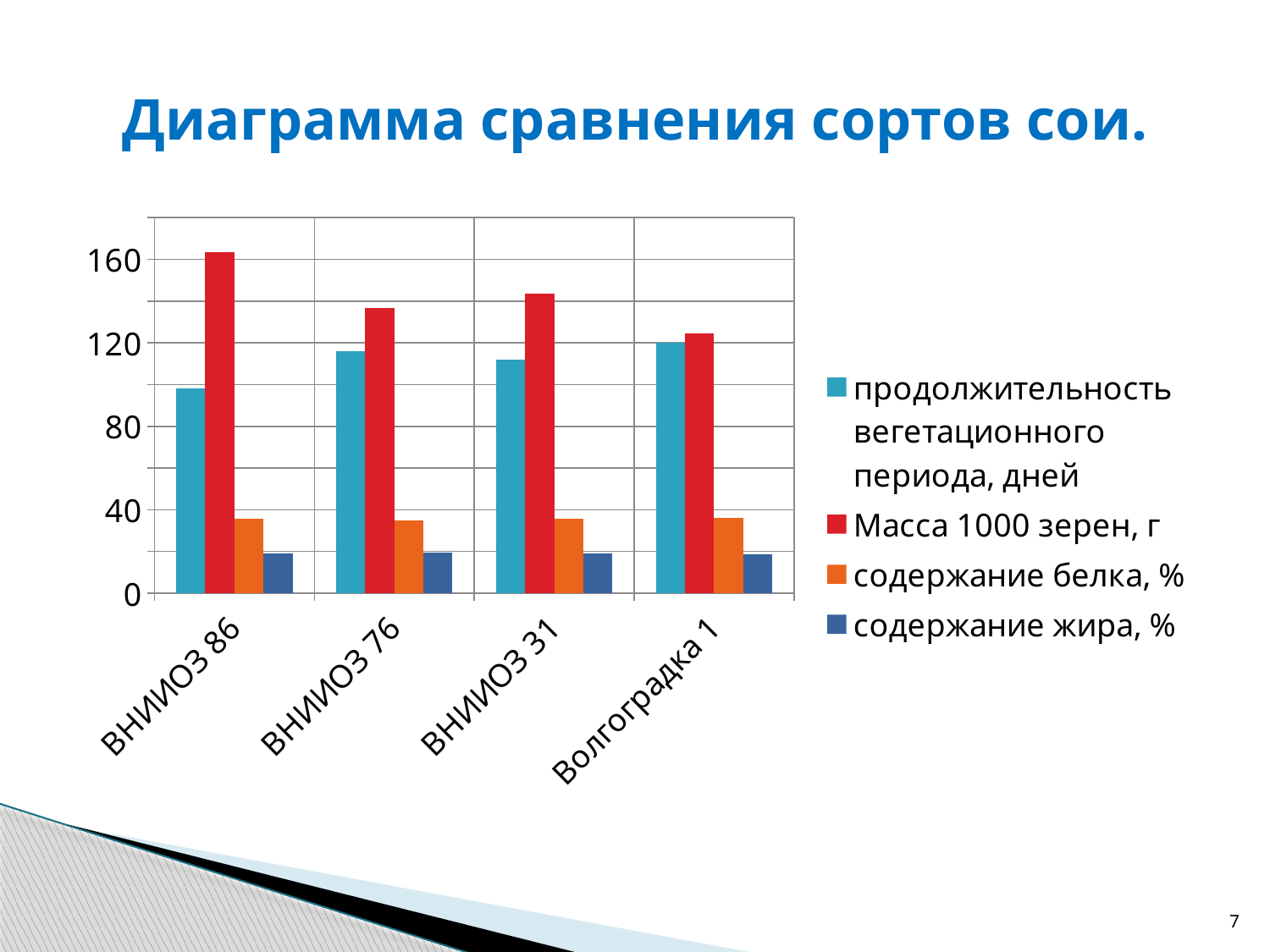
How many soybean varieties (categories) are shown on the x axis? 4 For ВНИИОЗ 86, which is larger: Масса 1000 зерен or продолжительность вегетационного периода? Масса 1000 зерен Which variety has the highest value for Масса 1000 зерен, г? ВНИИОЗ 86 What kind of chart is shown on the slide? bar chart Which variety has the lowest value for продолжительность вегетационного периода, дней? ВНИИОЗ 86 Is the value of Масса 1000 зерен for ВНИИОЗ 76 greater or less than 120? greater For ВНИИОЗ 76, which is larger: содержание белка or содержание жира? содержание белка Is the value of продолжительность вегетационного периода for ВНИИОЗ 86 greater or less than 120? less What is the title of the slide? Диаграмма сравнения сортов сои. Is the value of содержание белка, % for ВНИИОЗ 31 greater or less than 40? less Which variety has the lowest value for Масса 1000 зерен, г? Волгоградка 1 How many series does the legend list? 4